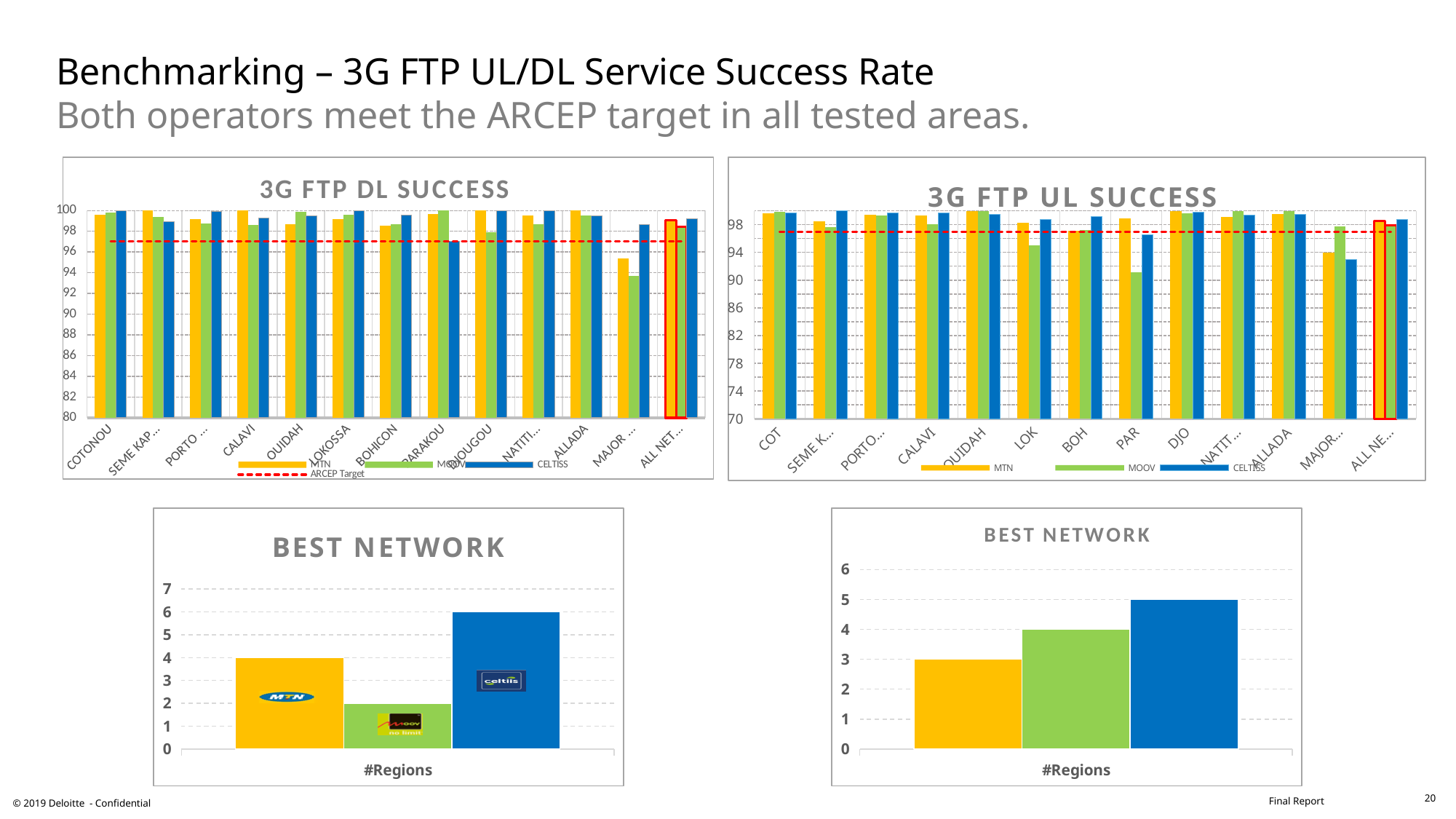
In the bottom-left BEST NETWORK chart, which operator has the lowest number of regions? MOOV How many categories are shown on the x axis of the 3G FTP DL SUCCESS chart? 13 What kind of chart is the bottom-left BEST NETWORK chart? bar chart In the bottom-right BEST NETWORK chart, what is the value of the green bar? 4 In the bottom-right BEST NETWORK chart, what is the total of the three bars? 12 How many operator series does the legend of the 3G FTP UL SUCCESS chart list? 3 In the 3G FTP DL SUCCESS chart, is the MOOV value for MAJOR... greater or less than 96? less In the bottom-left BEST NETWORK chart, what is the value of the blue CELTIIS bar? 6 In the bottom-right BEST NETWORK chart, which bar is the highest? the blue bar In the bottom-left BEST NETWORK chart, what is the difference between the CELTIIS bar and the MOOV bar? 4 In the bottom-left BEST NETWORK chart, what is the value of the yellow MTN bar? 4 In the 3G FTP UL SUCCESS chart, is the MOOV value for PAR greater or less than 94? less